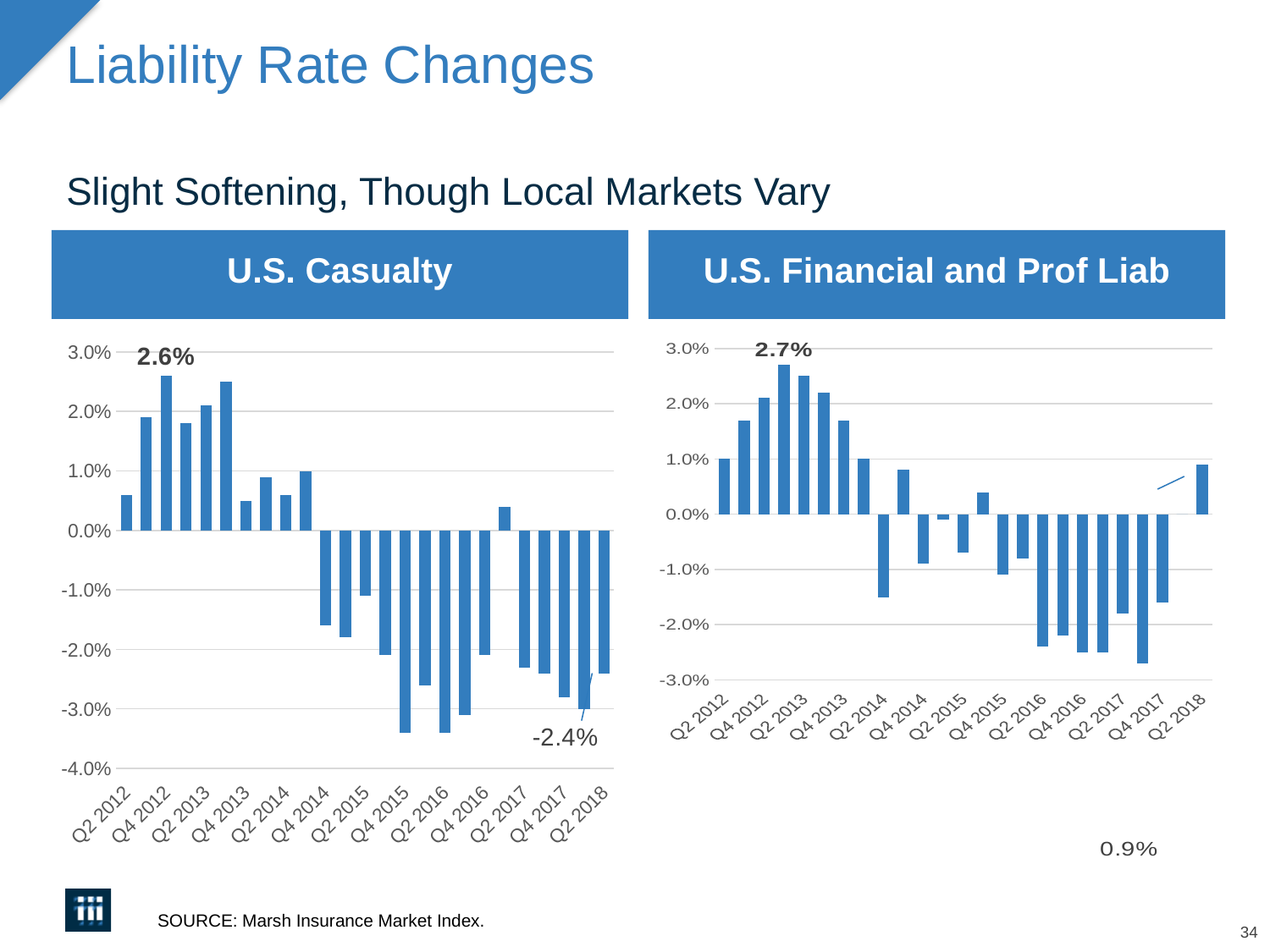
Which chart shows the larger value for Q2 2018, U.S. Casualty or U.S. Financial and Prof Liab? U.S. Financial and Prof Liab In the U.S. Financial and Prof Liab chart, what is the highest labeled rate change? 2.7% What is the lowest value shown on the y-axis of the U.S. Casualty chart? -4.0% In the U.S. Casualty chart, is the value for Q2 2012 greater or less than 1.0%? less In the U.S. Casualty chart, what is the difference between the labeled peak of 2.6% and the Q2 2018 value of -2.4%? 5.0 percentage points In the U.S. Casualty chart, what is the highest labeled rate change? 2.6% In the U.S. Casualty chart, what is the value for Q2 2018? -2.4% In the U.S. Casualty chart, do the values generally rise or fall from Q2 2012 to Q2 2018? fall In the U.S. Financial and Prof Liab chart, what is the value for Q2 2018? 0.9% In the U.S. Financial and Prof Liab chart, is the value for Q2 2014 greater or less than -1.0%? less What kind of chart is the U.S. Casualty chart? Bar chart What is the title of the chart on the right side of the slide? U.S. Financial and Prof Liab